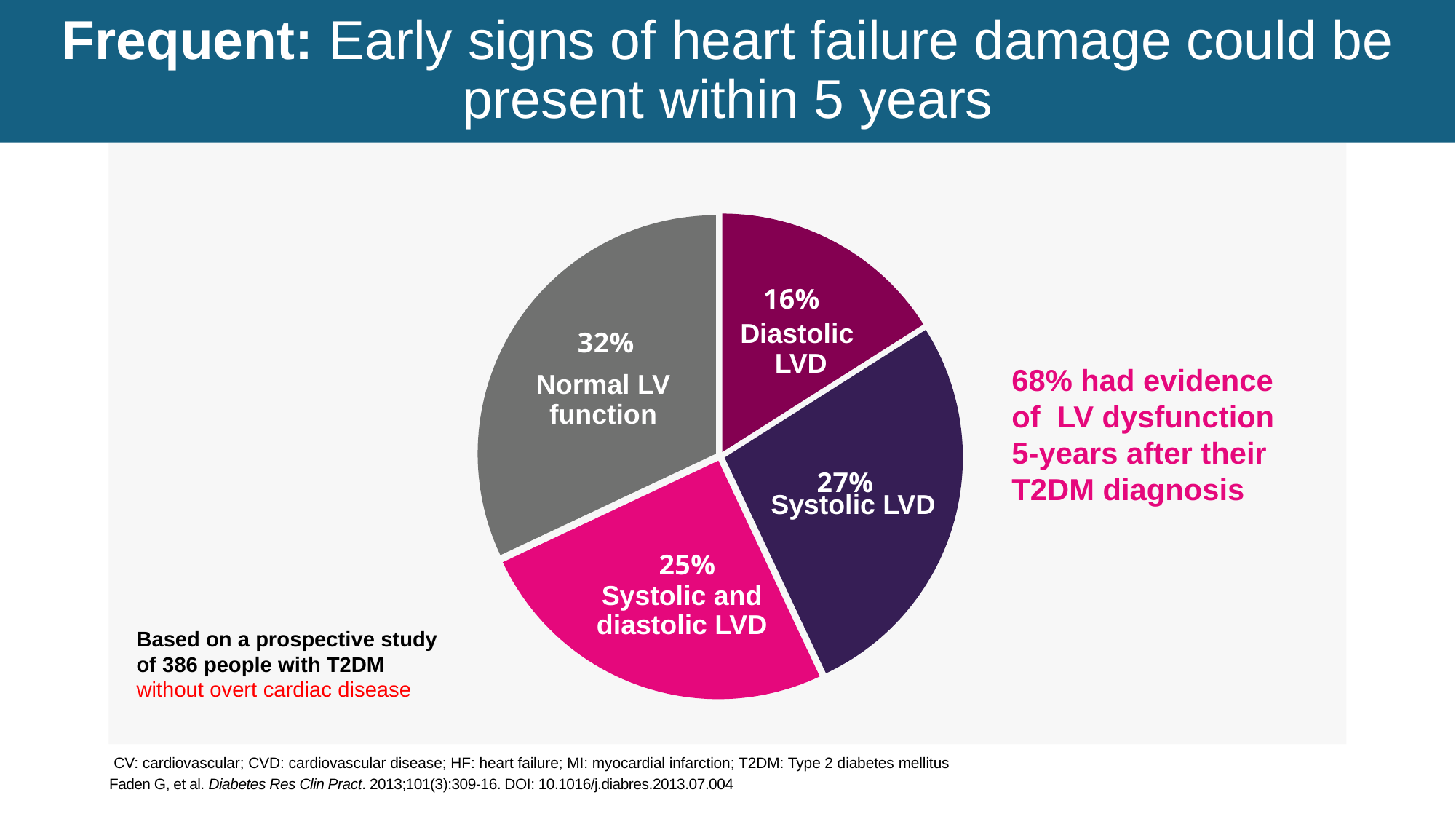
What is the difference in percentage points between the Systolic LVD slice and the Diastolic LVD slice? 11 How many slices does the pie chart have? 4 Which slice of the pie chart is the smallest? Diastolic LVD What colour is the Normal LV function slice of the pie chart? grey What percentage of the pie is labelled Normal LV function? 32% What percentage of the pie is labelled Systolic and diastolic LVD? 25% What percentage of the pie is labelled Diastolic LVD? 16% Which slice of the pie chart is the largest? Normal LV function Which is larger, the Systolic LVD slice or the Systolic and diastolic LVD slice? Systolic LVD What percentage of the pie is labelled Systolic LVD? 27% What is the combined share of the three LVD slices (Diastolic LVD, Systolic LVD, and Systolic and diastolic LVD)? 68% What kind of chart is shown on the slide? pie chart